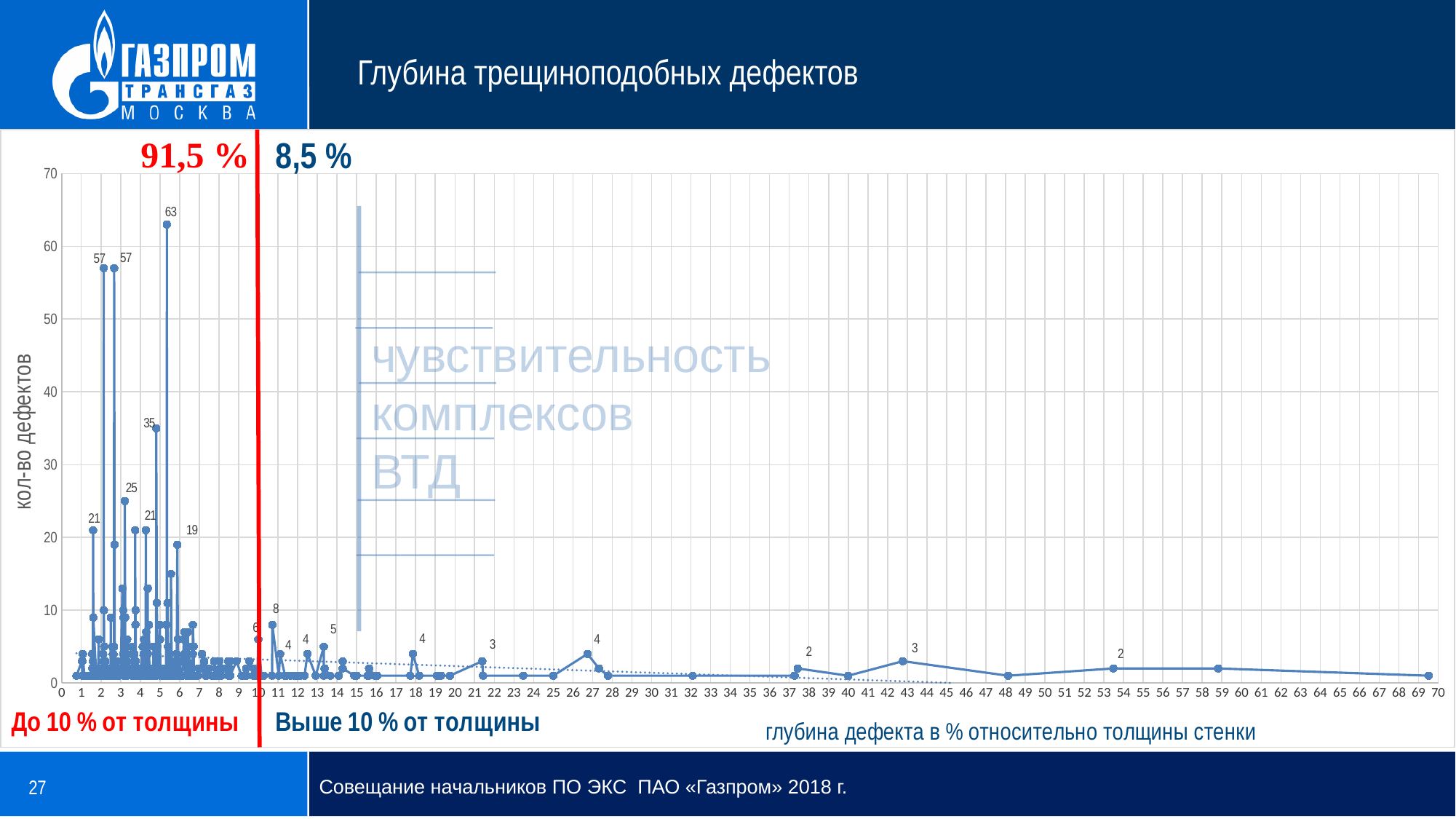
Which region has the larger share of defects: 'До 10 % от толщины' or 'Выше 10 % от толщины'? До 10 % от толщины What is the maximum value shown on the vertical axis? 70 What percentage of defects is shown for the region 'Выше 10 % от толщины'? 8,5 % Is the highest peak on the chart greater or less than 60? greater What is the label of the vertical axis? кол-во дефектов What percentage of defects is shown for the region 'До 10 % от толщины'? 91,5 % What is the difference between the highest labeled value (63) and the next highest labeled value (57)? 6 What is the highest data label shown on the chart? 63 What kind of chart is shown on the slide? line chart Do the defect counts generally rise or fall as the defect depth increases along the x axis? fall What is the maximum value shown on the horizontal axis? 70 What is the title of the chart on the slide? Глубина трещиноподобных дефектов